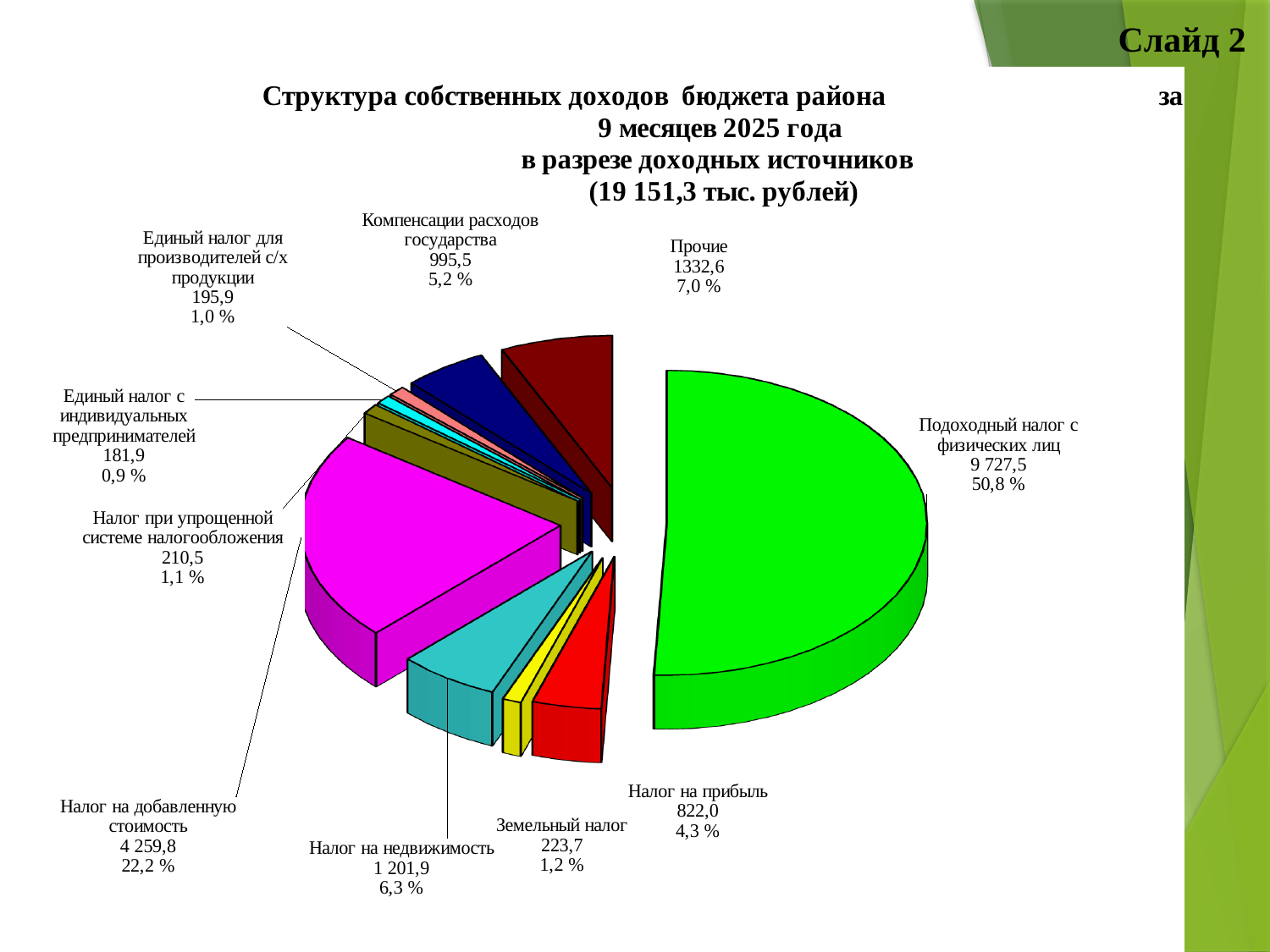
Which category has the largest slice in the pie chart? Подоходный налог с физических лиц What is the difference between the values for Прочие and Налог на недвижимость? 130,7 What kind of chart is shown on the slide? Pie chart What total amount (in тыс. рублей) is stated in the chart title? 19 151,3 тыс. рублей What share of the pie does Подоходный налог с физических лиц represent? 50,8 % What is the value shown for Налог на добавленную стоимость? 4 259,8 What share of the pie does Налог на прибыль represent? 4,3 % Which is larger: Прочие or Компенсации расходов государства? Прочие What is the difference between the values for Подоходный налог с физических лиц and Налог на добавленную стоимость? 5 467,7 What is the value shown for Налог на недвижимость? 1 201,9 Which category has the smallest slice in the pie chart? Единый налог с индивидуальных предпринимателей How many categories (slices) does the pie chart show? 10